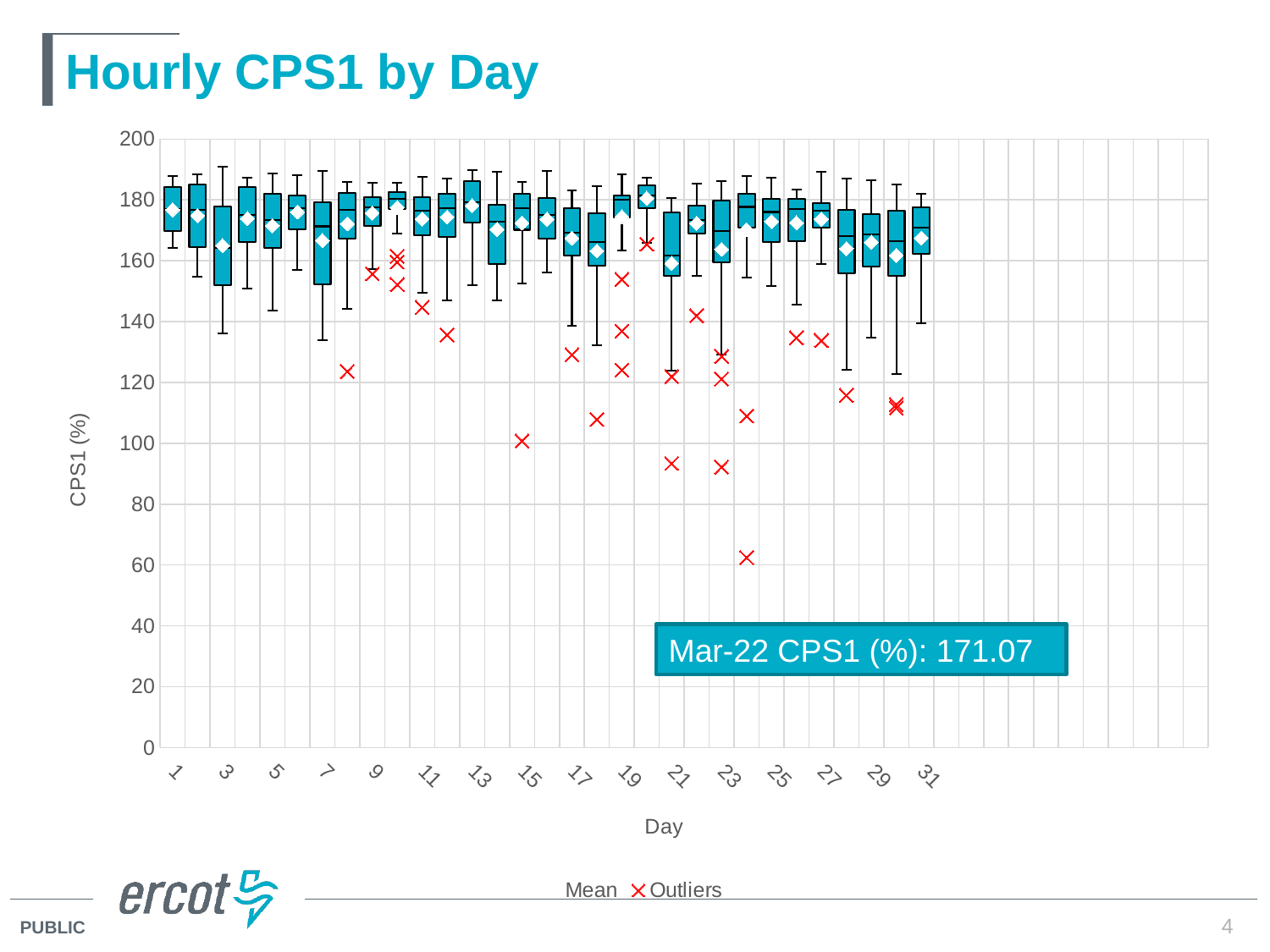
On which day does the lowest outlier appear? 24 What kind of chart is shown on the slide? Box plot (box-and-whisker chart) What is the label of the y axis? CPS1 (%) Is the outlier on day 15 greater or less than 120? less What is the title of the chart? Hourly CPS1 by Day What is the Mar-22 CPS1 (%) value shown in the text box on the chart? 171.07 How many entries does the chart legend list? 2 How many days (boxes) are plotted along the x axis? 31 What is the maximum value shown on the y axis? 200 Is the mean for day 1 greater or less than 160? greater Is the mean for day 21 greater or less than 180? less